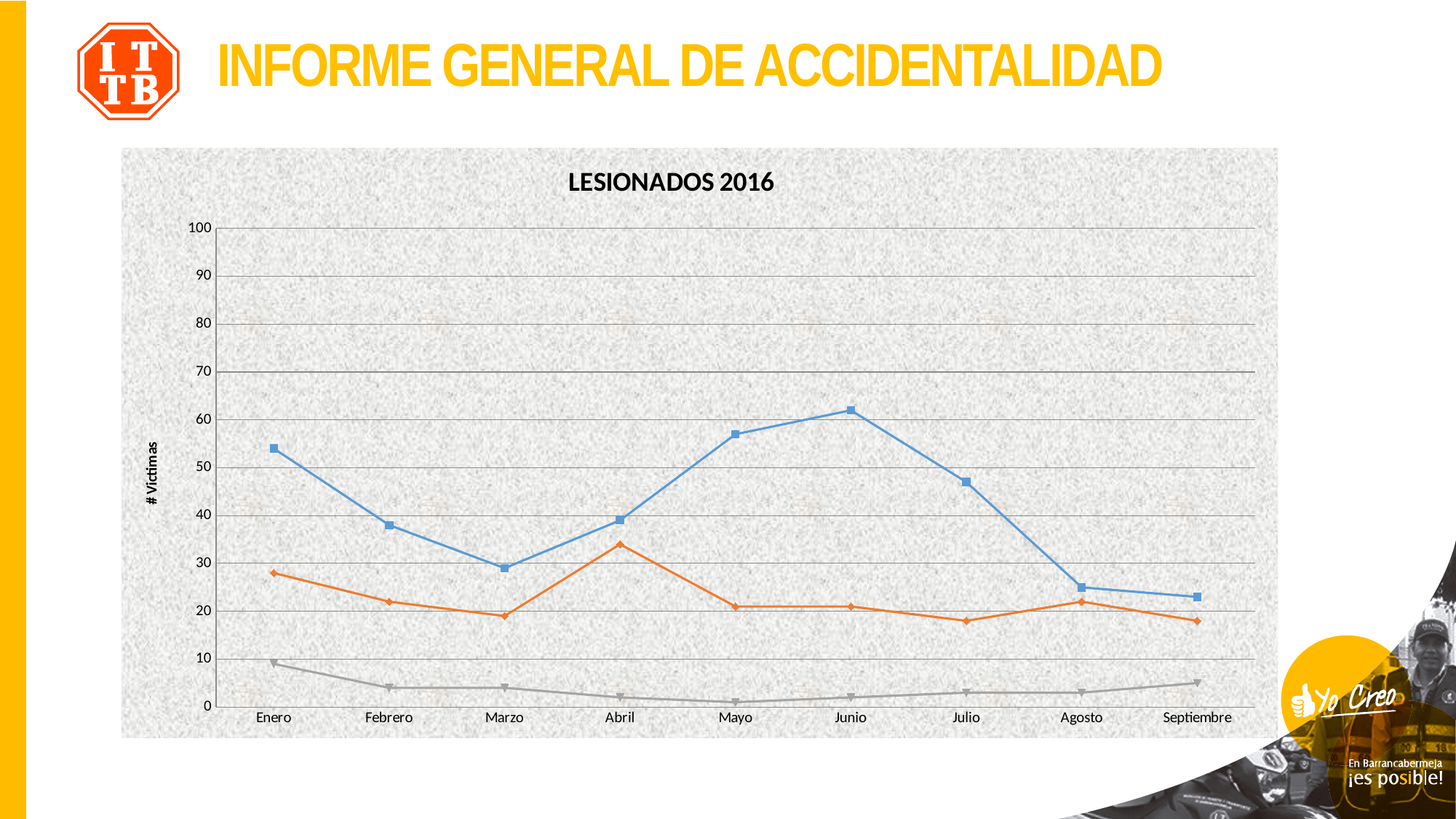
In which month does the gray line reach its highest value? Enero What is the label on the vertical axis of the chart? # Victimas What is the title of the chart? LESIONADOS 2016 In which month does the blue line reach its highest value? Junio What kind of chart is shown on the slide? Line chart Is the value of the blue line in Marzo greater or less than 40? less Does the blue line rise or fall from Junio to Septiembre? Fall Is the value of the orange line in Abril greater or less than 30? greater In Enero, which line has the larger value, the blue line or the orange line? Blue line How many months are shown along the x axis of the chart? 9 Is the value of the blue line in Junio greater or less than 50? greater In which month does the orange line reach its highest value? Abril